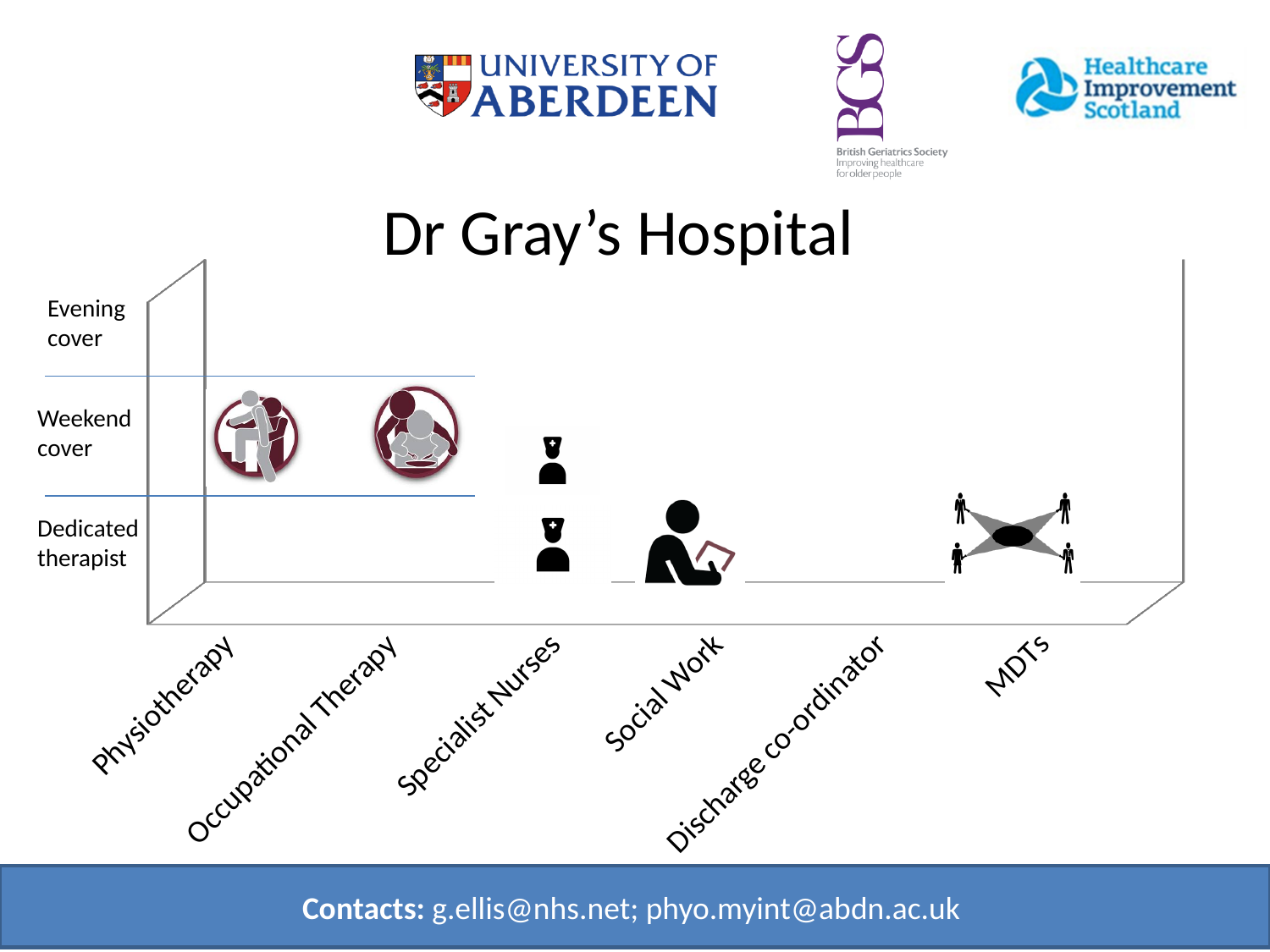
Which level does the Social Work icon reach? Dedicated therapist What is the highest level labelled on the vertical axis? Evening cover What kind of chart is shown on the slide? bar chart How many categories are shown along the x axis of the chart? 6 Which category on the x axis has no icon plotted above it? Discharge co-ordinator Which reaches a higher level of cover, Specialist Nurses or Social Work? Specialist Nurses What is the title of the chart? Dr Gray's Hospital Does any category reach the Evening cover level? No How many levels are labelled on the vertical axis of the chart? 3 Up to which level of cover does the Occupational Therapy icon reach? Weekend cover Up to which level do the Specialist Nurses icons reach? Weekend cover Up to which level of cover does the Physiotherapy icon reach? Weekend cover